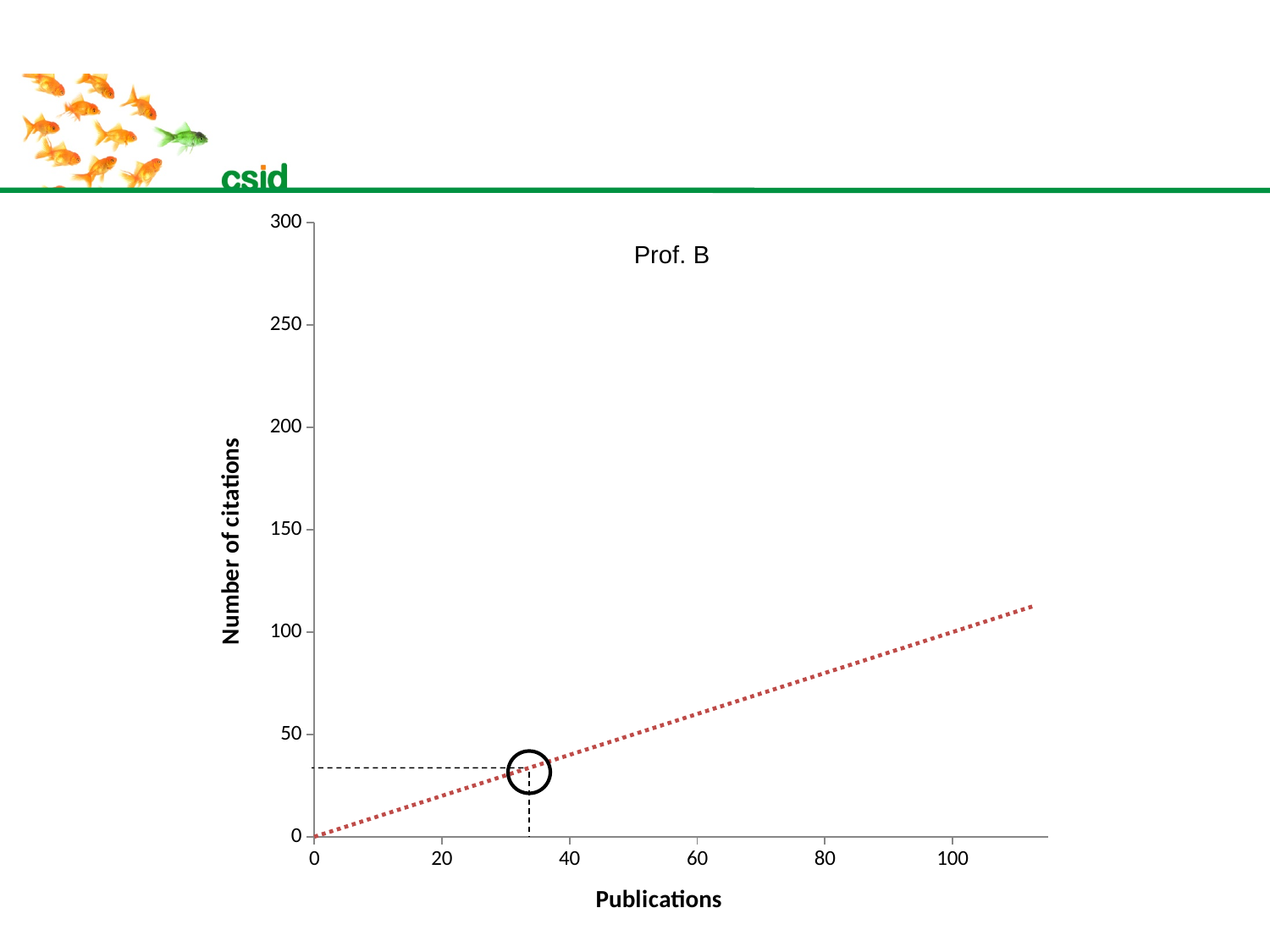
What kind of chart is shown on the slide? line chart What is the title of the chart? Prof. B What is the label of the vertical axis? Number of citations Is the number of citations at 40 publications greater or less than 50? less Is the number of citations at 100 publications greater or less than 150? less Is the number of citations at 80 publications greater or less than 100? less Does the dotted line rise or fall as the number of publications increases? rise Which has more citations on the dotted line: 60 publications or 20 publications? 60 publications What is the highest value shown on the vertical axis? 300